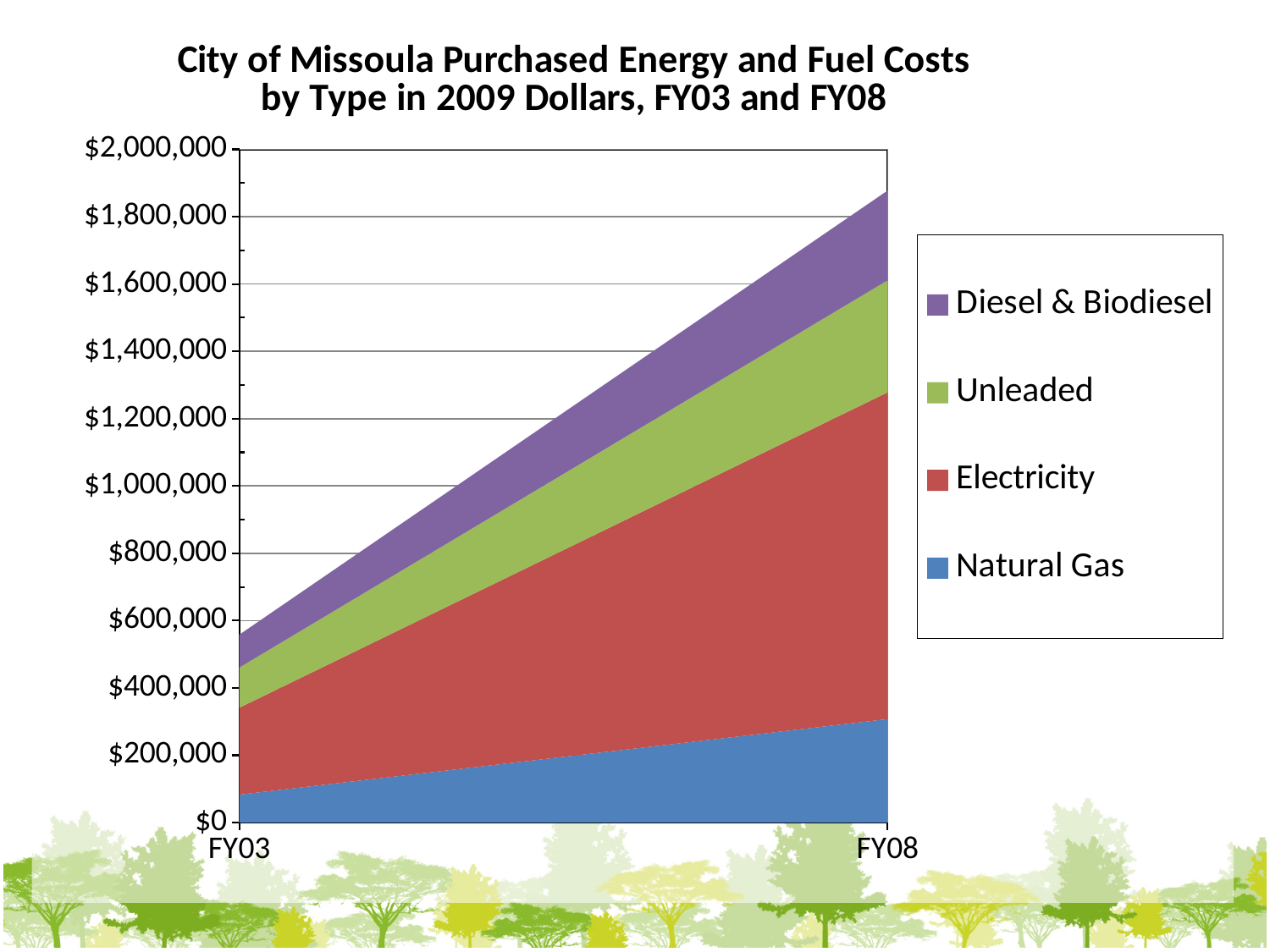
Is the Natural Gas cost in FY03 greater or less than $200,000? less Which is larger in FY08, the Electricity cost or the Natural Gas cost? Electricity Is the total stacked cost for FY08 greater or less than $1,600,000? greater How many fiscal years are plotted along the x axis? 2 How many series does the legend list? 4 Is the total stacked cost for FY03 greater or less than $800,000? less What kind of chart is shown on the slide? Stacked area chart Which series is listed first (at the top) in the legend? Diesel & Biodiesel Do total purchased energy and fuel costs rise or fall from FY03 to FY08? Rise Which energy or fuel type accounts for the largest share of costs in FY08? Electricity What colour represents Electricity in the chart? Red